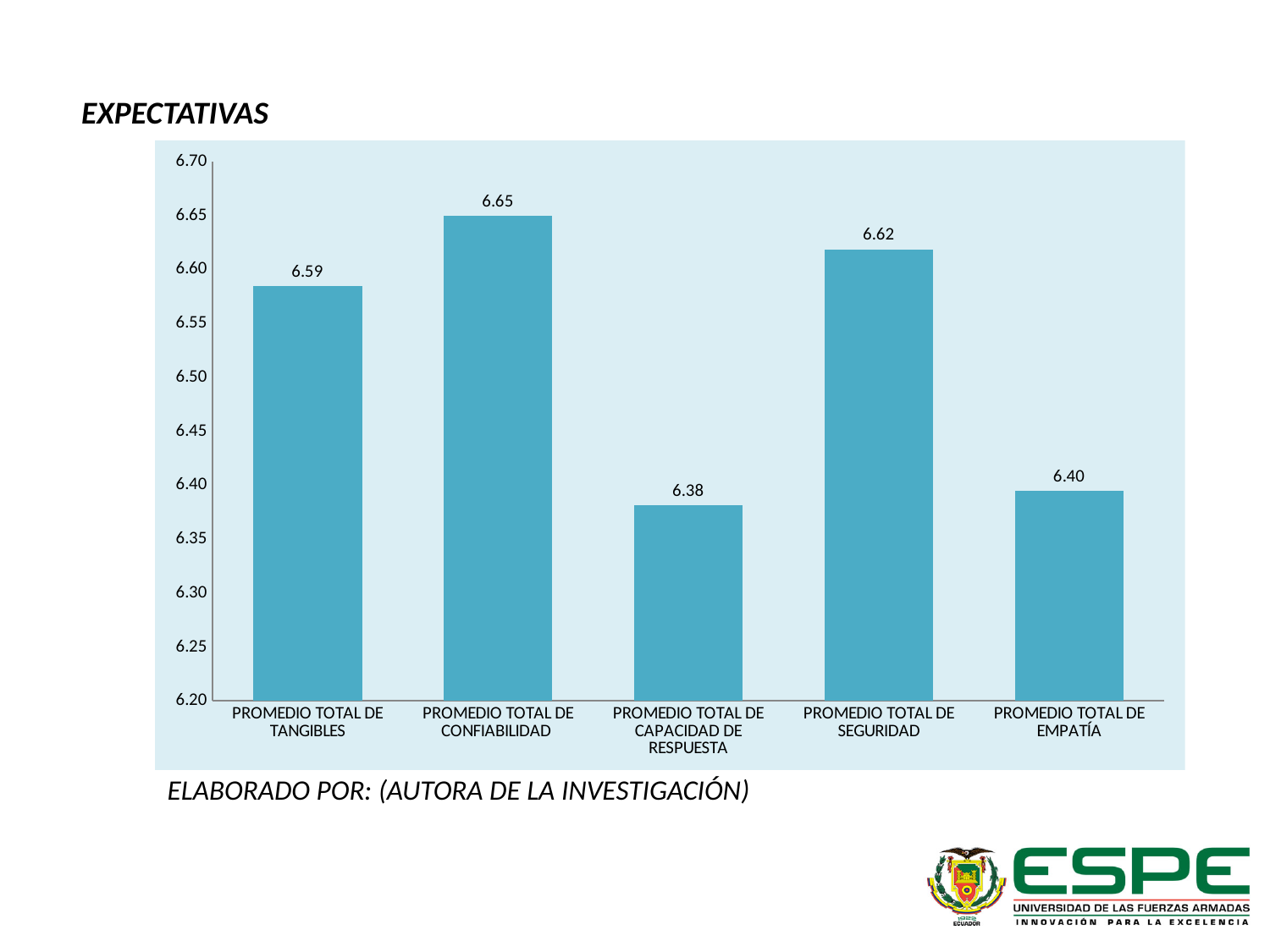
Which category has the highest value? PROMEDIO TOTAL DE CONFIABILIDAD What is the value for PROMEDIO TOTAL DE EMPATÍA? 6.40 What is the value for PROMEDIO TOTAL DE SEGURIDAD? 6.62 What kind of chart is shown on the slide? Bar chart How many categories are shown in the chart? 5 Which category has the lowest value? PROMEDIO TOTAL DE CAPACIDAD DE RESPUESTA Which is larger, the value for PROMEDIO TOTAL DE TANGIBLES or PROMEDIO TOTAL DE EMPATÍA? PROMEDIO TOTAL DE TANGIBLES What is the title shown above the chart? EXPECTATIVAS What is the value for PROMEDIO TOTAL DE TANGIBLES? 6.59 What is the value for PROMEDIO TOTAL DE CAPACIDAD DE RESPUESTA? 6.38 What is the value for PROMEDIO TOTAL DE CONFIABILIDAD? 6.65 What is the difference between the values for PROMEDIO TOTAL DE CONFIABILIDAD and PROMEDIO TOTAL DE CAPACIDAD DE RESPUESTA? 0.27